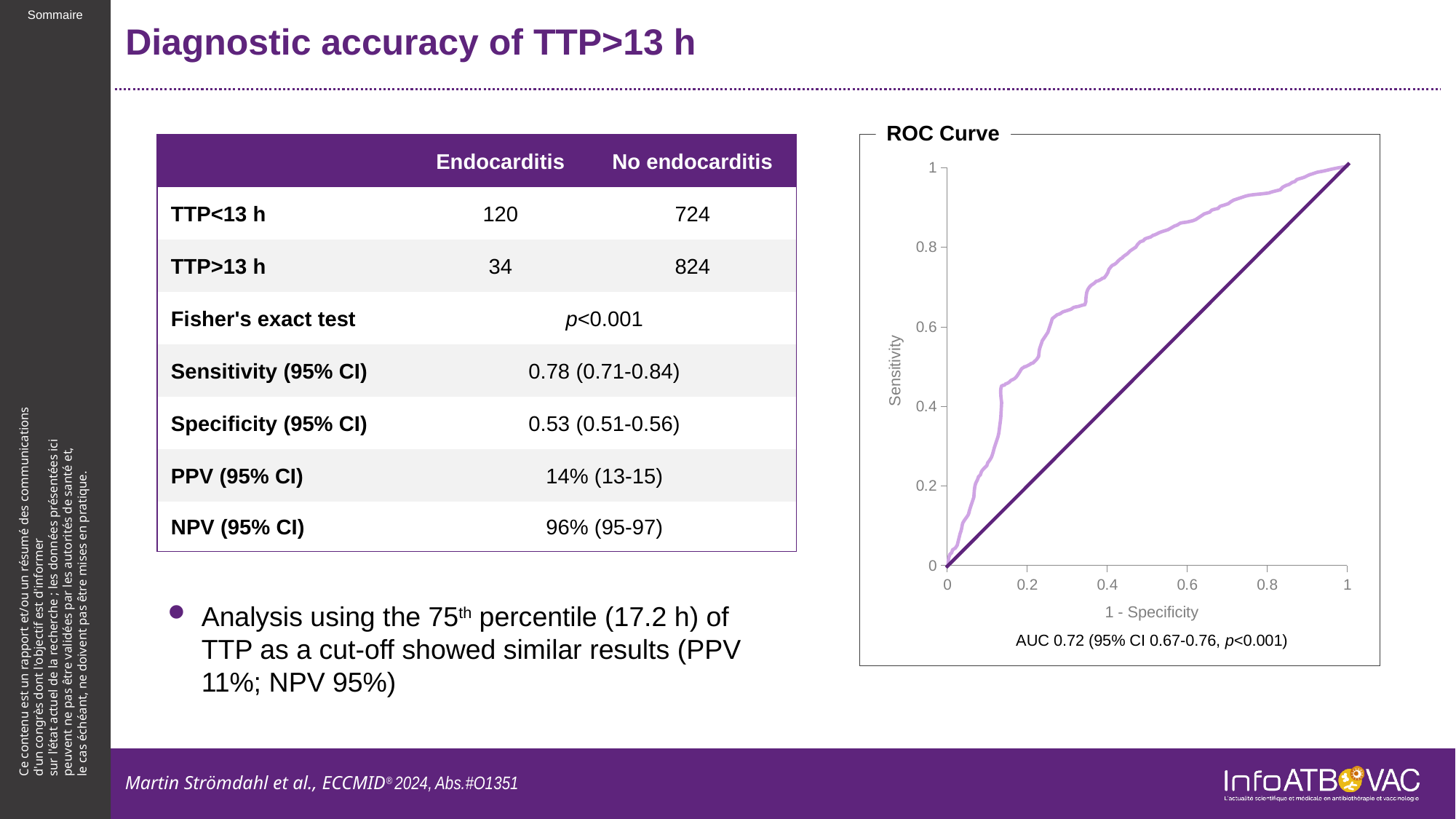
How many lines are plotted in the ROC Curve chart? 2 What is the highest tick value shown on the x axis of the ROC Curve chart? 1 In the ROC Curve chart, does the ROC curve rise or fall as 1 - Specificity increases from 0 to 1? rise In the ROC Curve chart, is the sensitivity at 1 - Specificity = 0.4 greater or less than 0.6? greater What kind of chart is shown under the title "ROC Curve"? line chart What is the label of the y axis of the ROC Curve chart? Sensitivity In the ROC Curve chart, is the sensitivity at 1 - Specificity = 0.2 greater or less than 0.4? greater What is the 95% CI for the AUC printed below the ROC Curve chart? 0.67-0.76 What is the title of the chart on the right of the slide? ROC Curve What AUC value is printed below the ROC Curve chart? 0.72 In the ROC Curve chart, is the sensitivity at 1 - Specificity = 0.1 greater or less than 0.6? less